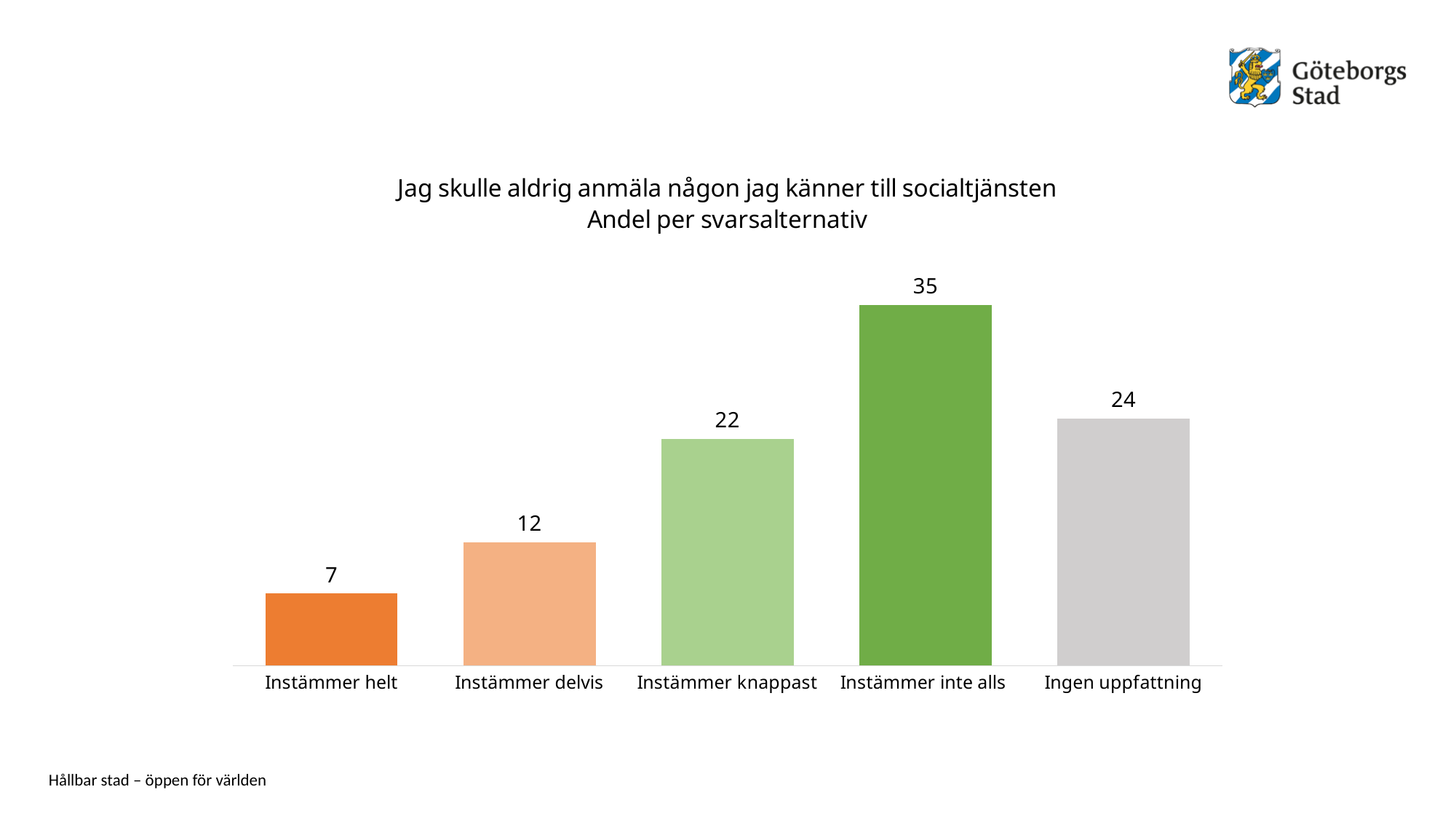
What is the value for Ingen uppfattning? 24 Which category has the highest value? Instämmer inte alls Which category has the lowest value? Instämmer helt Which is larger, the value for Instämmer delvis or the value for Instämmer knappast? Instämmer knappast What is the value for Instämmer helt? 7 What is the value for Instämmer delvis? 12 How many categories are shown on the x axis? 5 What kind of chart is shown on the slide? Bar chart What is the value for Instämmer knappast? 22 What is the difference between the values for Instämmer inte alls and Ingen uppfattning? 11 What is the second line of the chart title? Andel per svarsalternativ What is the difference between the values for Instämmer knappast and Instämmer helt? 15